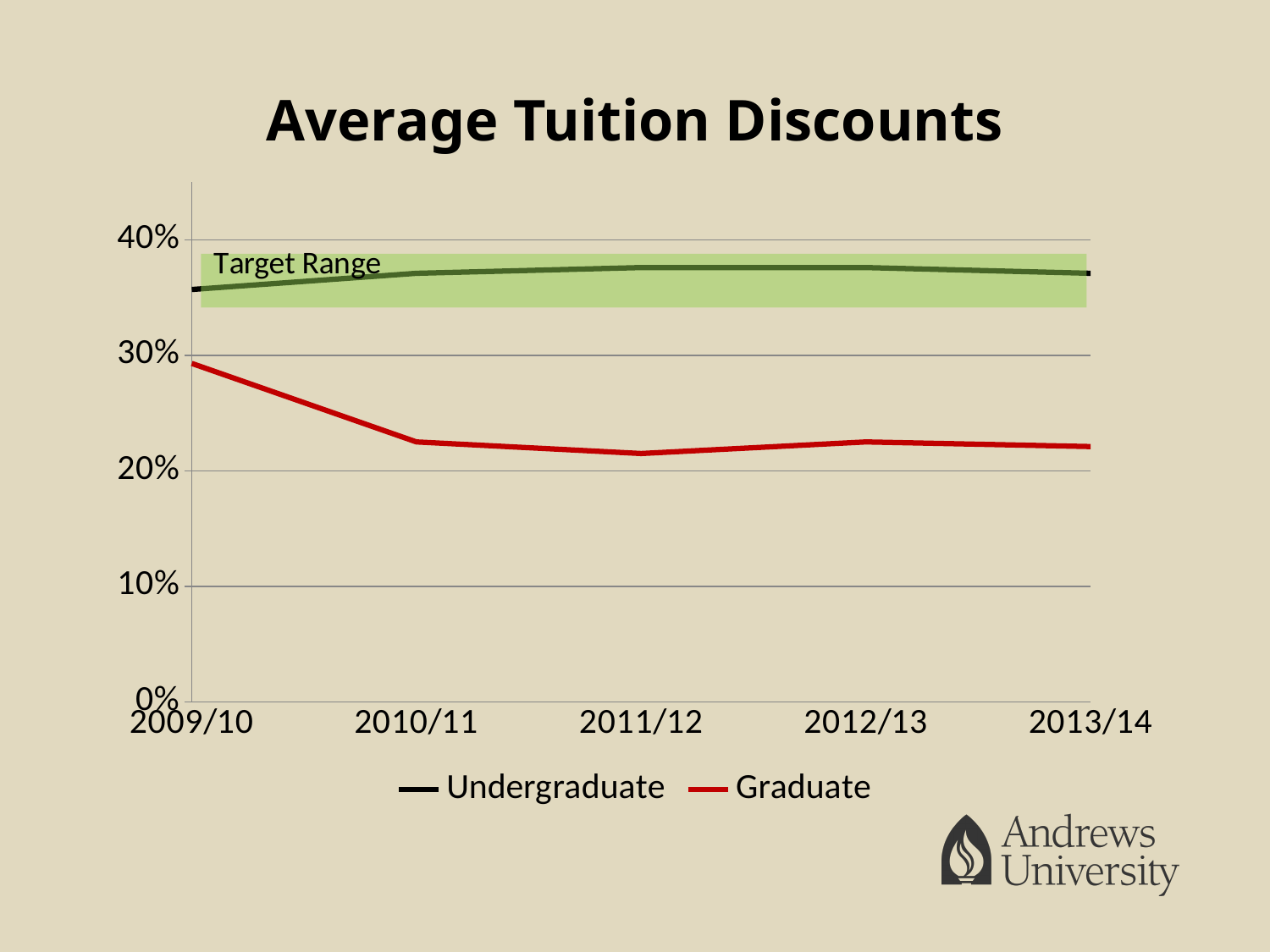
How many series does the legend list? 2 Is the Undergraduate value for 2013/14 greater or less than 40%? less Is the Undergraduate value for 2009/10 greater or less than 30%? greater What is the title of the chart? Average Tuition Discounts How many academic years are plotted along the x axis? 5 What label is shown on the green shaded band? Target Range Does the Graduate line rise or fall from 2009/10 to 2010/11? Fall In which year is the Graduate discount highest? 2009/10 Is the Graduate value for 2010/11 greater or less than 20%? greater What kind of chart is shown on the slide? Line chart In 2011/12, which series has the higher value, Undergraduate or Graduate? Undergraduate